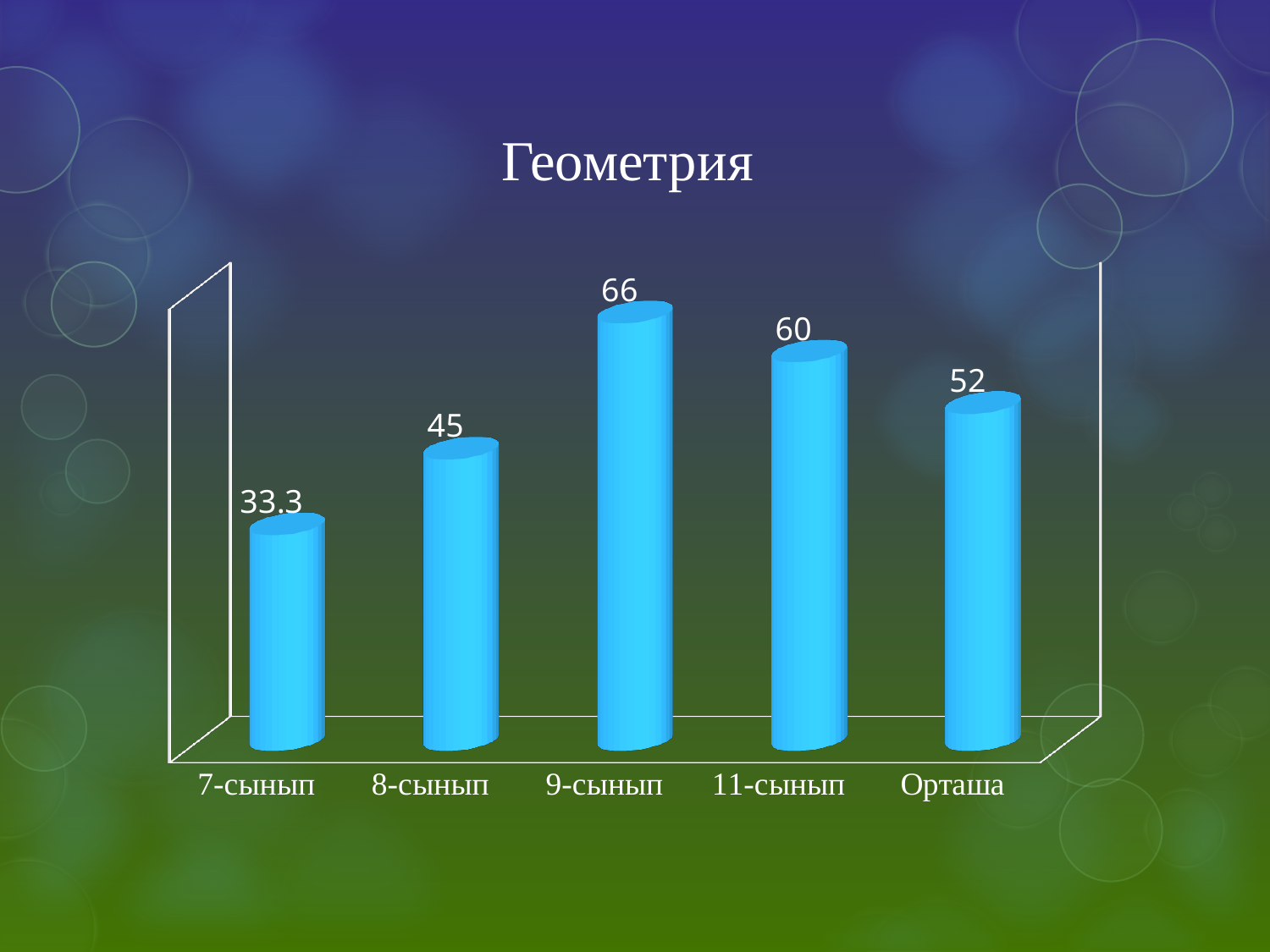
How many categories are shown on the x axis? 5 Which is larger, the value for 11-сынып or the value for Орташа? 11-сынып Do the values rise or fall from 7-сынып to 9-сынып? rise What is the value for 9-сынып? 66 What is the difference between the values for 8-сынып and 7-сынып? 11.7 Which category has the highest value? 9-сынып What is the value for Орташа? 52 What is the difference between the values for 9-сынып and 11-сынып? 6 Which category has the lowest value? 7-сынып What is the title of the chart? Геометрия What kind of chart is this? bar chart What is the value for 7-сынып? 33.3